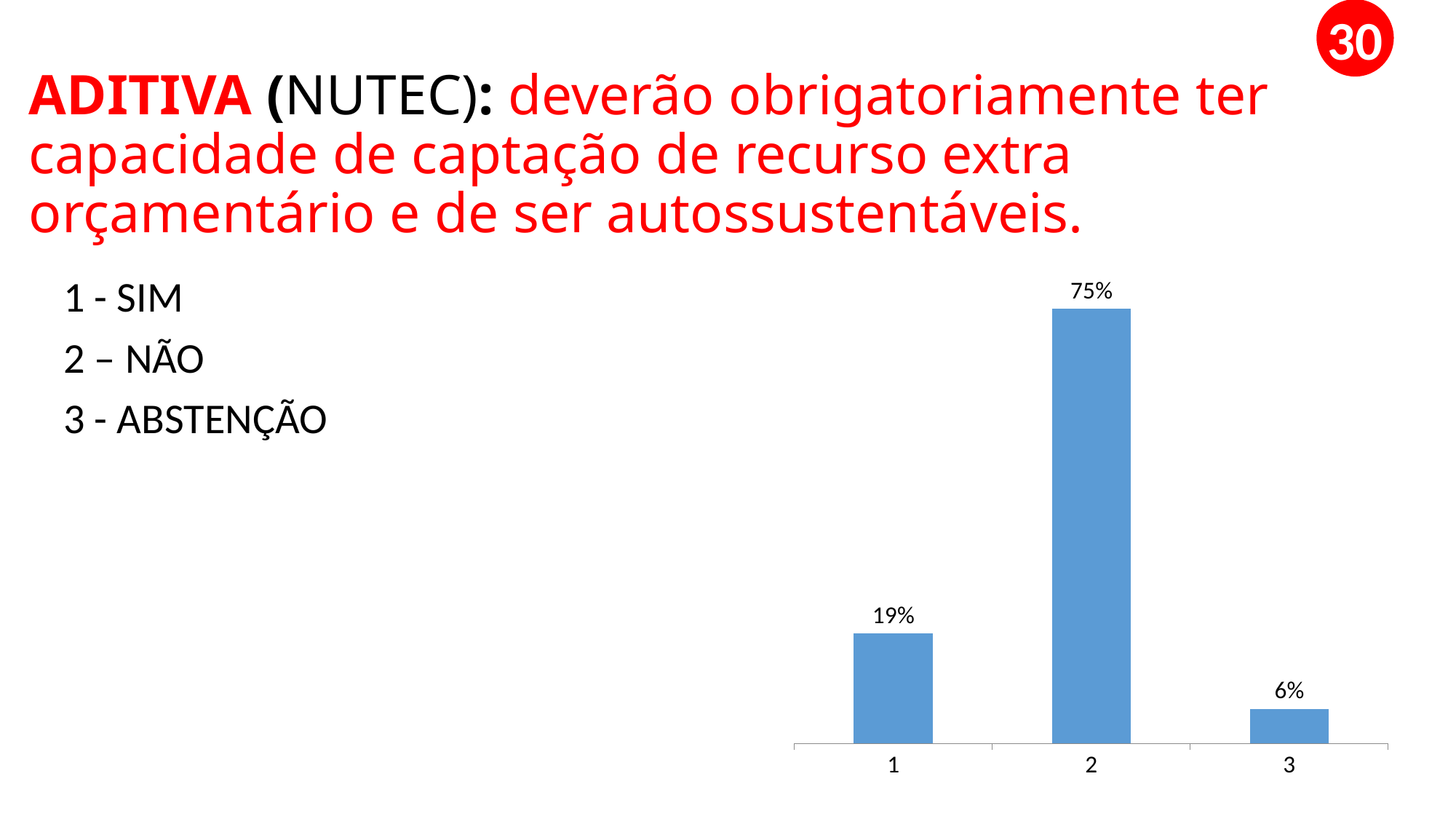
What is the value shown for category 1 in the bar chart? 19% What is the difference between the values for category 1 and category 3? 13% Which category has the lowest value in the bar chart? 3 What is the value shown for category 3 in the bar chart? 6% What is the value shown for category 2 in the bar chart? 75% How many categories are plotted in the bar chart? 3 What kind of chart is shown on the slide? Bar chart Which category has the highest value in the bar chart? 2 Which is larger, the value for category 1 or the value for category 3? Category 1 What colour are the bars in the chart? Blue According to the slide's key, what does category 2 in the chart stand for? NÃO What is the difference between the values for category 2 and category 1? 56%